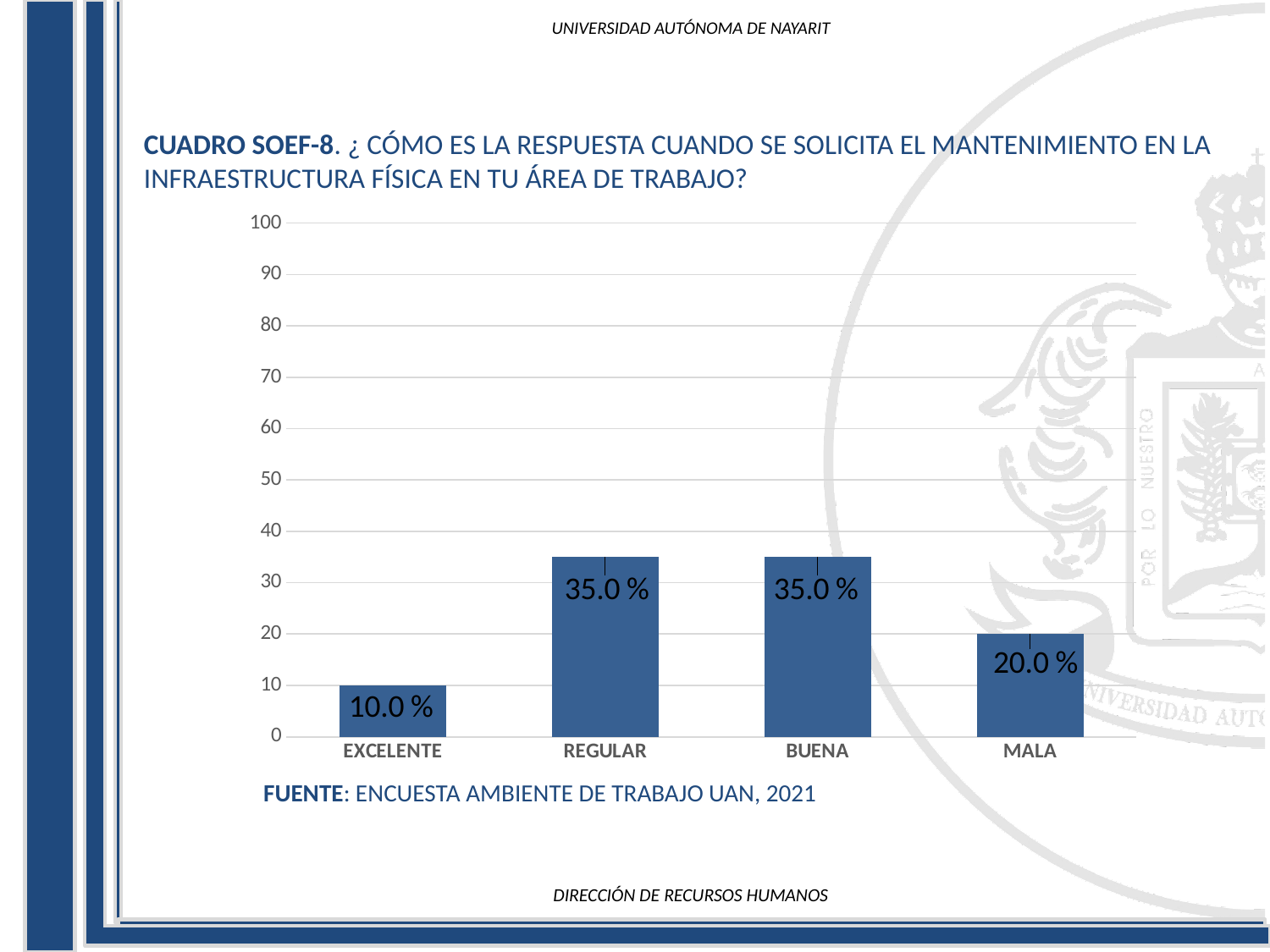
What is the source cited below the chart? ENCUESTA AMBIENTE DE TRABAJO UAN, 2021 What is the value for MALA? 20.0 % Which is larger, the value for MALA or the value for EXCELENTE? MALA What is the difference between the values for BUENA and MALA? 15.0 % How many categories are shown on the x axis? 4 What kind of chart is shown on the slide? bar chart Which category has the lowest value? EXCELENTE What is the value for EXCELENTE? 10.0 % What is the value for REGULAR? 35.0 % What is the highest value shown on the vertical axis? 100 What is the difference between the values for MALA and EXCELENTE? 10.0 % Is the value for BUENA greater or less than 30? greater